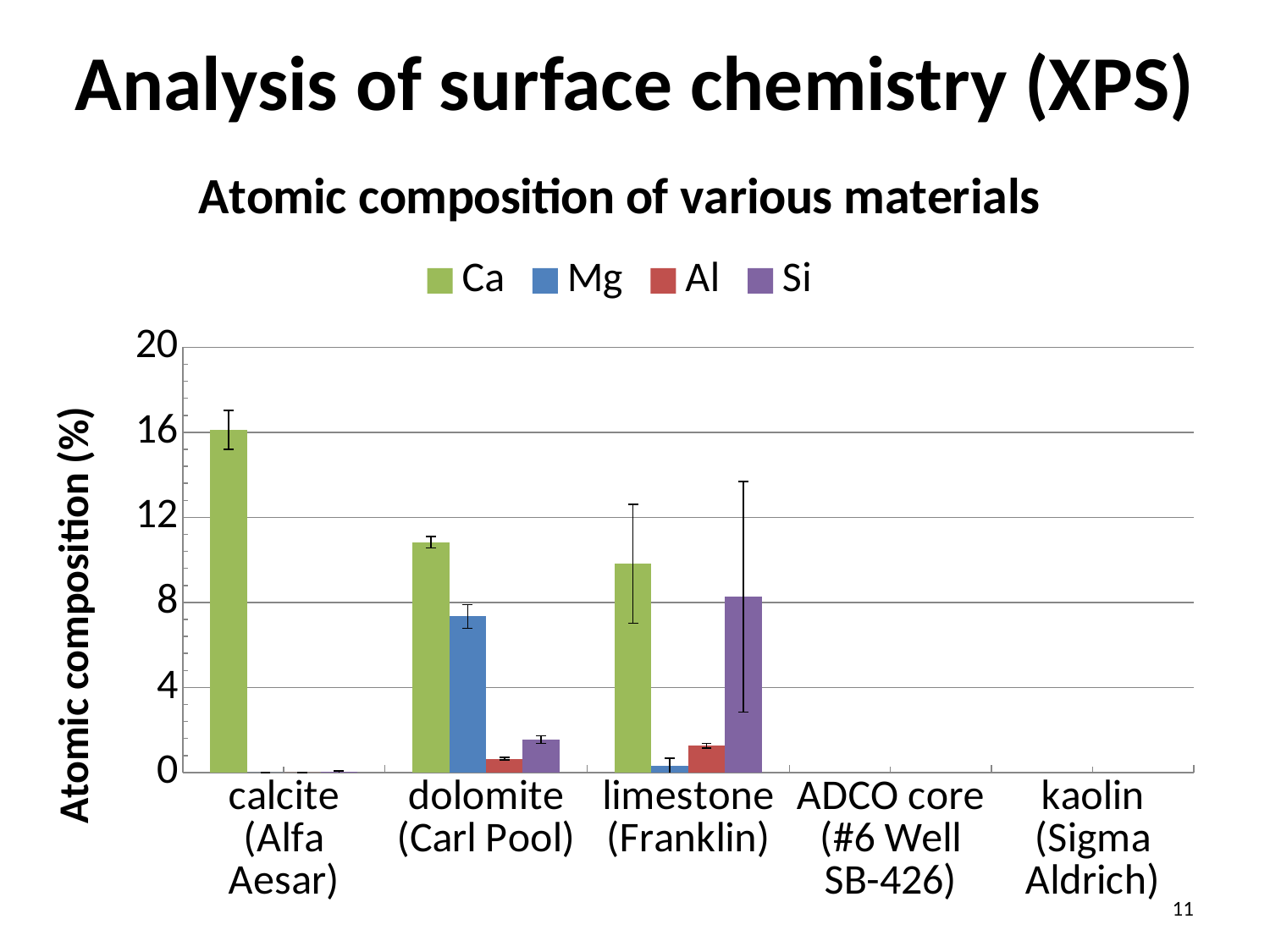
Which material has the highest Ca value? calcite (Alfa Aesar) How many material categories are shown on the x axis? 5 Is the Mg value for dolomite (Carl Pool) greater or less than 8? less What is the label of the y axis? Atomic composition (%) Which is larger for dolomite (Carl Pool): the Ca value or the Mg value? Ca What is the title of the chart? Atomic composition of various materials How many series does the legend list? 4 Which material has the highest Si value? limestone (Franklin) Is the Si value for limestone (Franklin) greater or less than 4? greater Is the Ca value for calcite (Alfa Aesar) greater or less than 12? greater What kind of chart is shown on the slide? bar chart